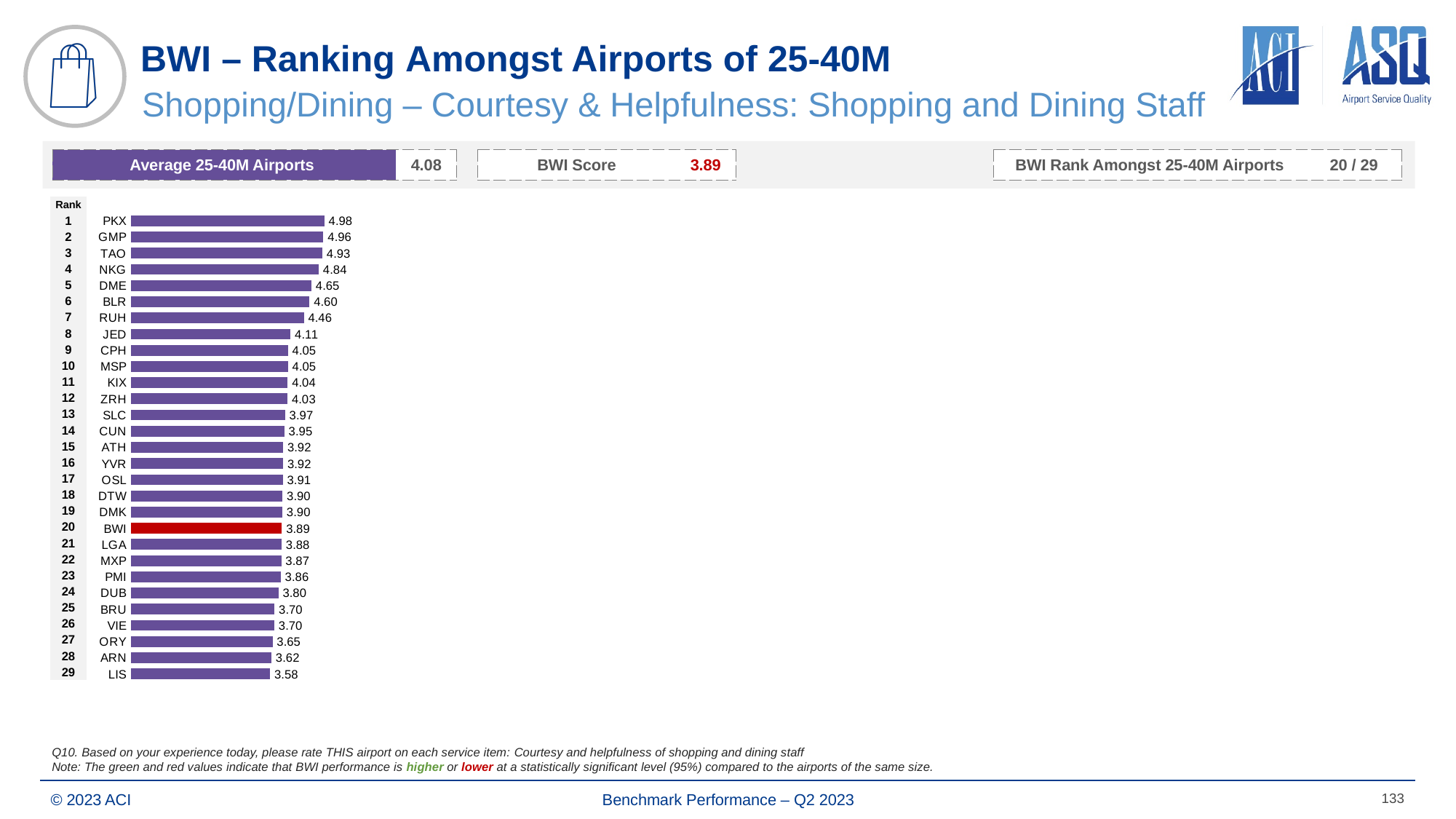
Which airport has the highest score on the chart? PKX What is the score for LIS? 3.58 What kind of chart is shown on the slide? Bar chart How many airports are ranked on the chart? 29 Which has a higher score, DME or JED? DME Which airport has the lowest score on the chart? LIS What is the difference between the scores of PKX and BWI? 1.09 What is the score for ORY? 3.65 What is the score for BWI on the chart? 3.89 Which bar on the chart is coloured red? BWI What is the score for PKX? 4.98 What is the difference between the score of DUB and the score of BRU? 0.10